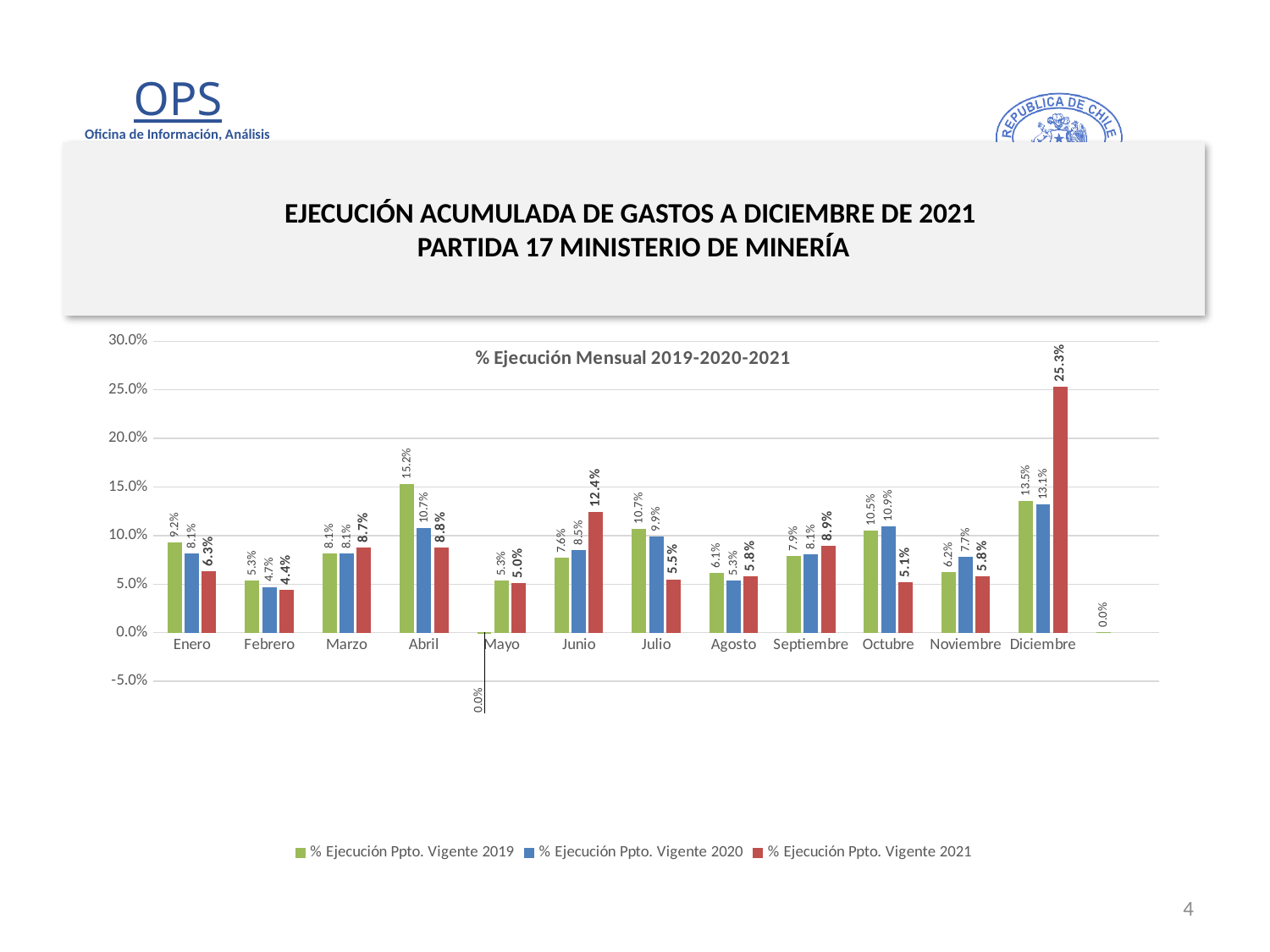
In which month is the % Ejecución Ppto. Vigente 2019 value highest? Abril What is the value for % Ejecución Ppto. Vigente 2021 in Diciembre? 25.3% What kind of chart is shown on the slide? Bar chart In which month is the % Ejecución Ppto. Vigente 2021 value highest? Diciembre In which month is the % Ejecución Ppto. Vigente 2021 value lowest? Febrero What is the value for % Ejecución Ppto. Vigente 2021 in Junio? 12.4% How many series does the legend list? 3 What is the value for % Ejecución Ppto. Vigente 2020 in Octubre? 10.9% In Junio, which series has the larger value: % Ejecución Ppto. Vigente 2019 or % Ejecución Ppto. Vigente 2021? % Ejecución Ppto. Vigente 2021 What is the value for % Ejecución Ppto. Vigente 2019 in Abril? 15.2% Is the value for % Ejecución Ppto. Vigente 2019 in Abril greater or less than 10.0%? greater What is the difference between the 2021 and 2020 values in Diciembre? 12.2 percentage points